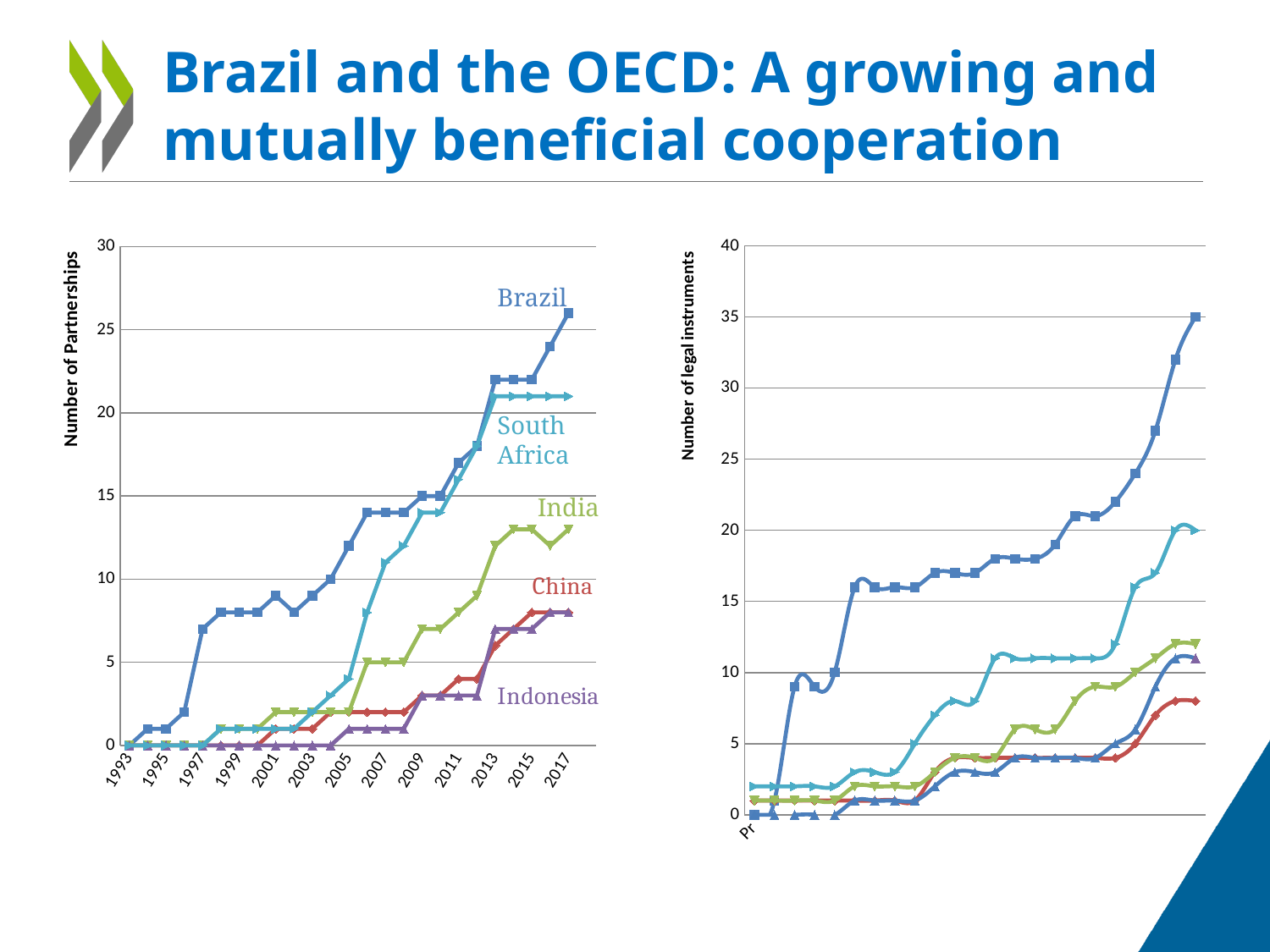
What kind of chart is the left chart, 'Number of Partnerships'? line chart In the left chart, 'Number of Partnerships', does the Brazil line generally rise or fall from 1993 to 2017? rise In the left chart, 'Number of Partnerships', which is larger in 2017: the value for South Africa or the value for India? South Africa In the left chart, 'Number of Partnerships', is the value for India in 2017 greater or less than 15? less In the left chart, 'Number of Partnerships', how many countries are plotted? 5 What is the y-axis title of the right chart? Number of legal instruments What is the maximum value shown on the y axis of the left chart, 'Number of Partnerships'? 30 In the left chart, 'Number of Partnerships', is the value for Brazil in 2017 greater or less than 25? greater In the left chart, 'Number of Partnerships', which country has the highest value in 2017? Brazil In the left chart, 'Number of Partnerships', is the value for China in 2017 greater or less than 10? less In the right chart, 'Number of legal instruments', what value does the highest line reach at its final point? 35